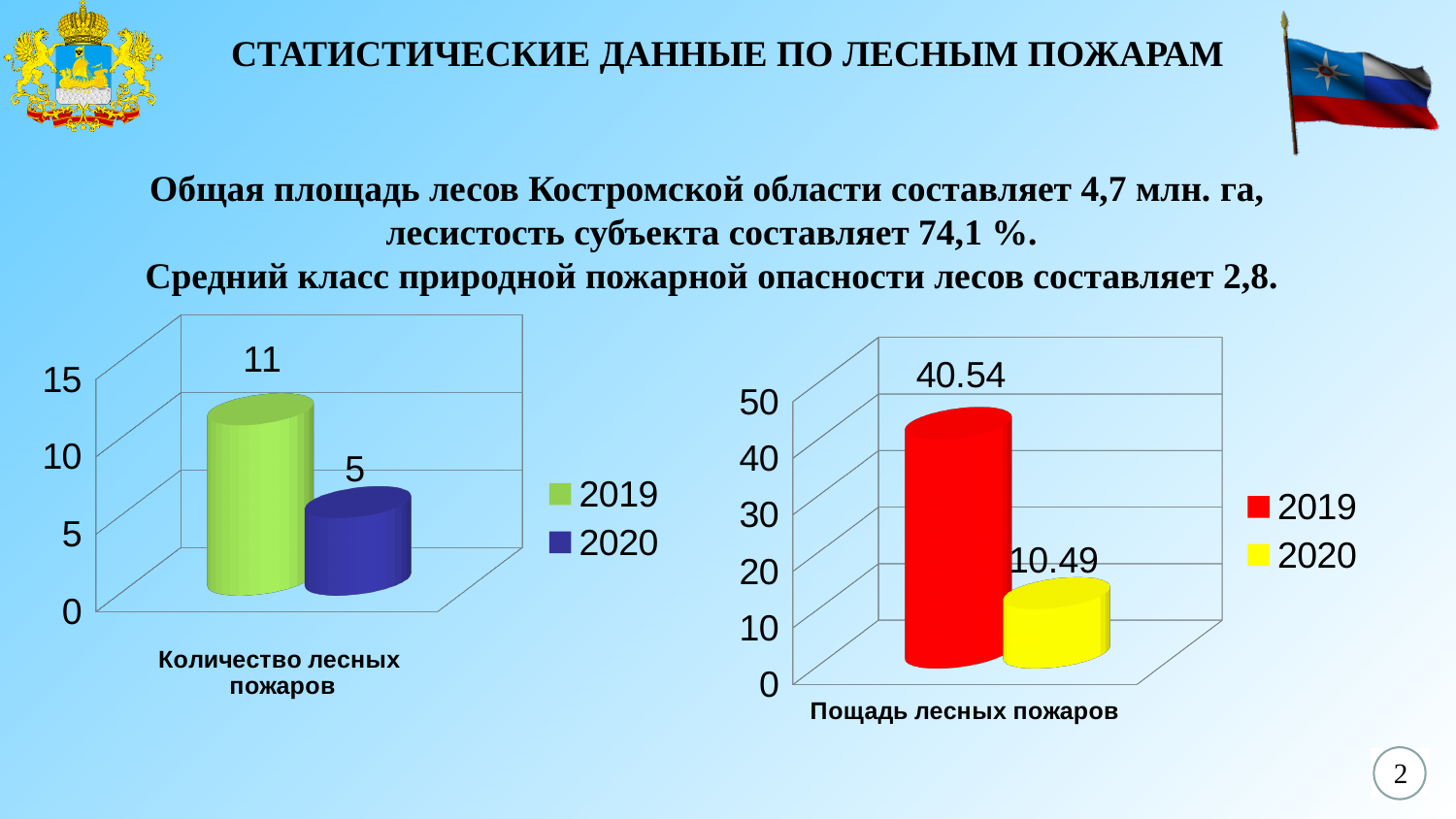
In the left chart (Количество лесных пожаров), which year has the higher value? 2019 In the left chart (Количество лесных пожаров), what is the value for 2020? 5 In the right chart (Пощадь лесных пожаров), what colour is the bar for 2020? yellow In the right chart (Пощадь лесных пожаров), which year has the lower value? 2020 In the right chart (Пощадь лесных пожаров), what is the difference between the 2019 and 2020 values? 30.05 How many series does the legend of the left chart (Количество лесных пожаров) list? 2 In the right chart (Пощадь лесных пожаров), what is the value for 2020? 10.49 In the right chart (Пощадь лесных пожаров), what is the value for 2019? 40.54 In the left chart (Количество лесных пожаров), what is the difference between the 2019 and 2020 values? 6 In the left chart (Количество лесных пожаров), what is the value for 2019? 11 In the right chart (Пощадь лесных пожаров), is the value for 2019 greater or less than 30? greater What kind of chart is the right chart (Пощадь лесных пожаров)? bar chart